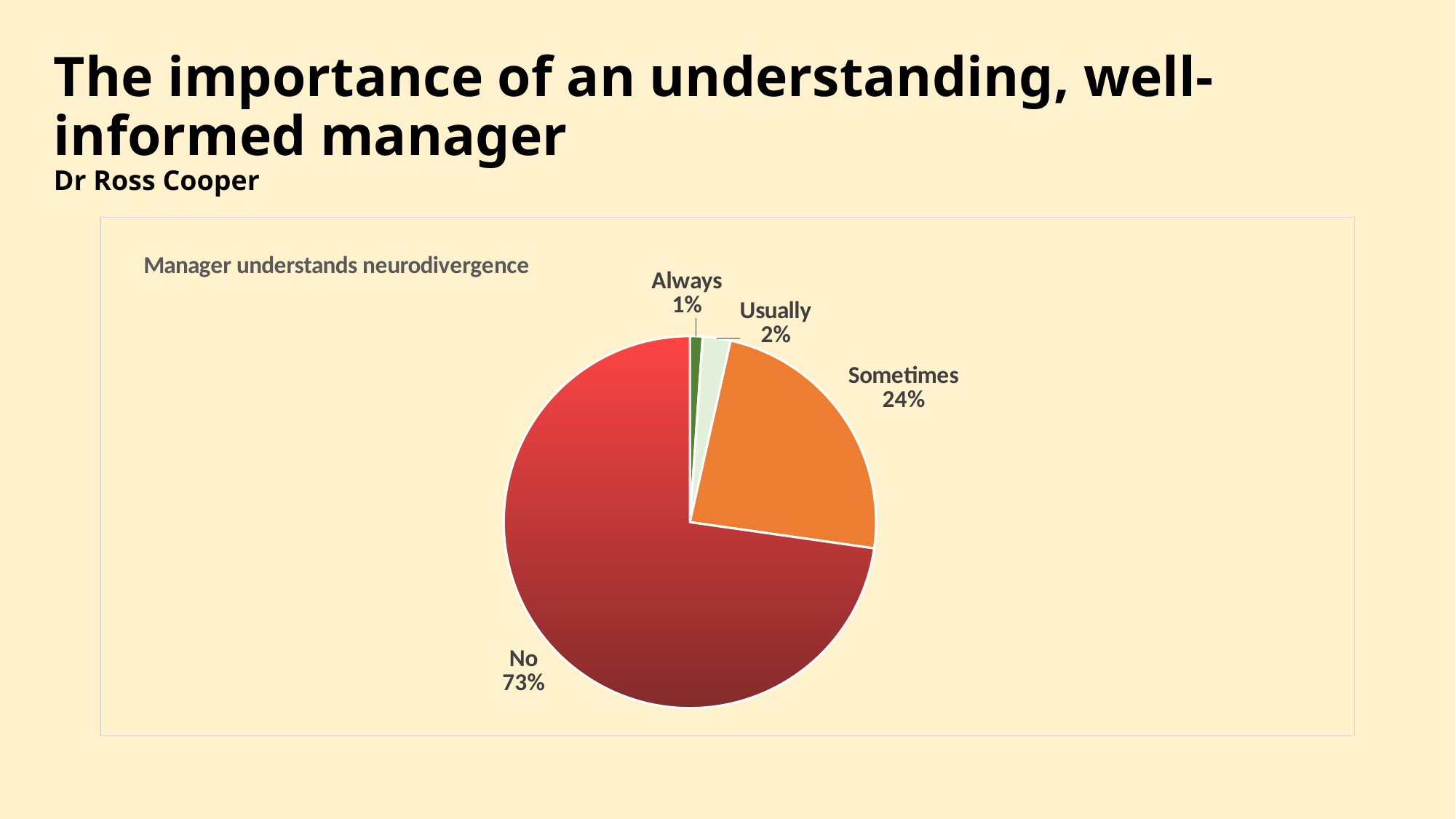
What colour is the "Sometimes" slice? orange What is the difference in percentage points between the "No" slice and the "Sometimes" slice? 49 Which category has the largest slice of the pie? No What is the title of the chart? Manager understands neurodivergence What share of the pie is labelled "Always"? 1% Which slice is larger, "Sometimes" or "Usually"? Sometimes What share of the pie is labelled "Sometimes"? 24% Which category has the smallest slice of the pie? Always What share of the pie is labelled "Usually"? 2% How many slices does the pie chart have? 4 What kind of chart is shown on the slide? pie chart